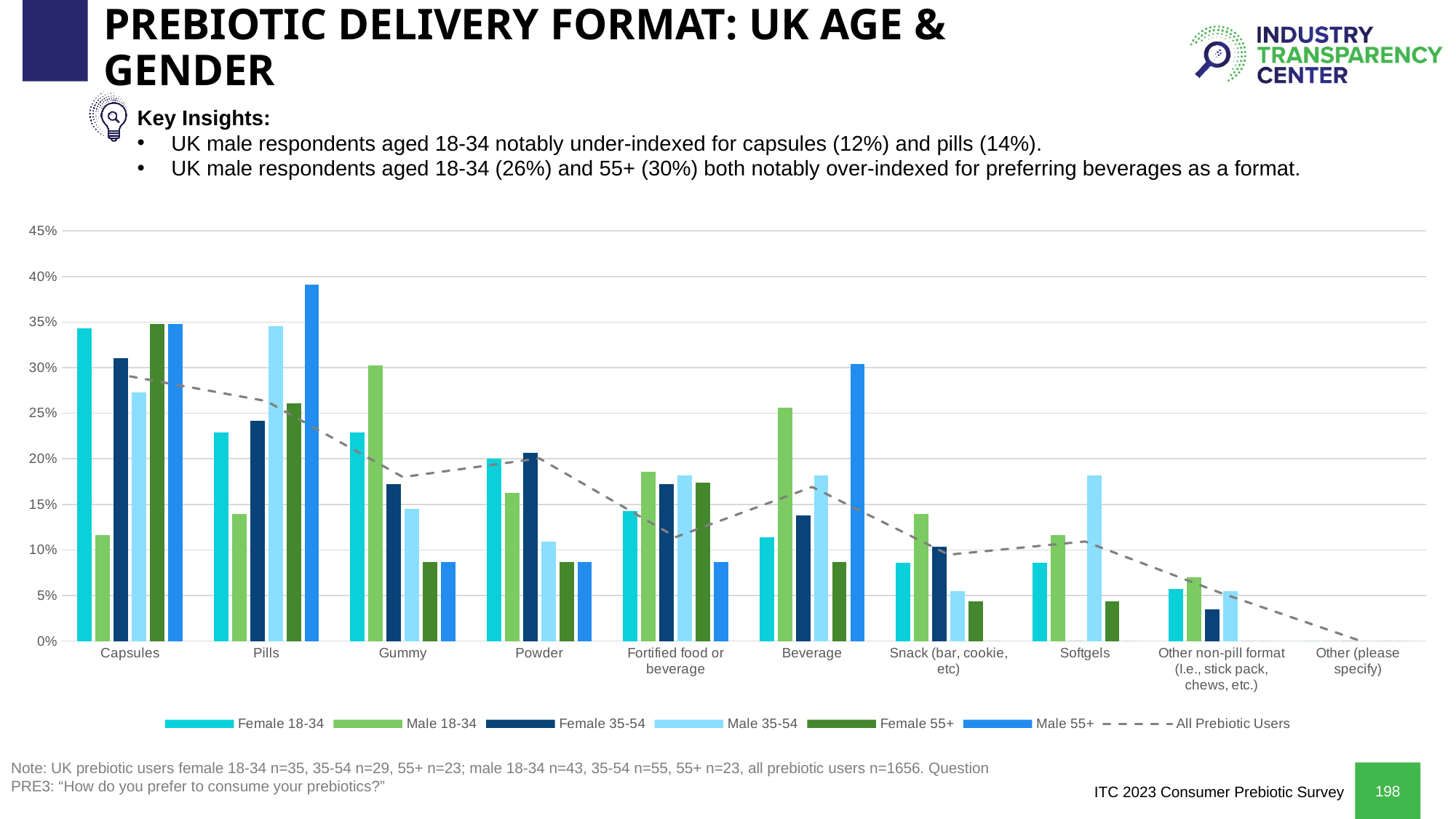
Is the value for Female 55+ for Gummy greater or less than 10%? less What kind of chart is shown on the slide? combination bar and line chart Is the value for Female 18-34 for Capsules greater or less than 30%? greater Is the value for Male 35-54 for Softgels greater or less than 15%? greater Which series is represented by the dashed grey line? All Prebiotic Users For Capsules, which is larger: Female 18-34 or Male 18-34? Female 18-34 Which series has the tallest bar for Pills? Male 55+ How many entries does the legend list? 7 Does the dashed All Prebiotic Users line generally rise or fall from Capsules to Other (please specify)? fall How many delivery format categories are shown on the x axis? 10 For Beverage, which is larger: Male 55+ or Female 55+? Male 55+